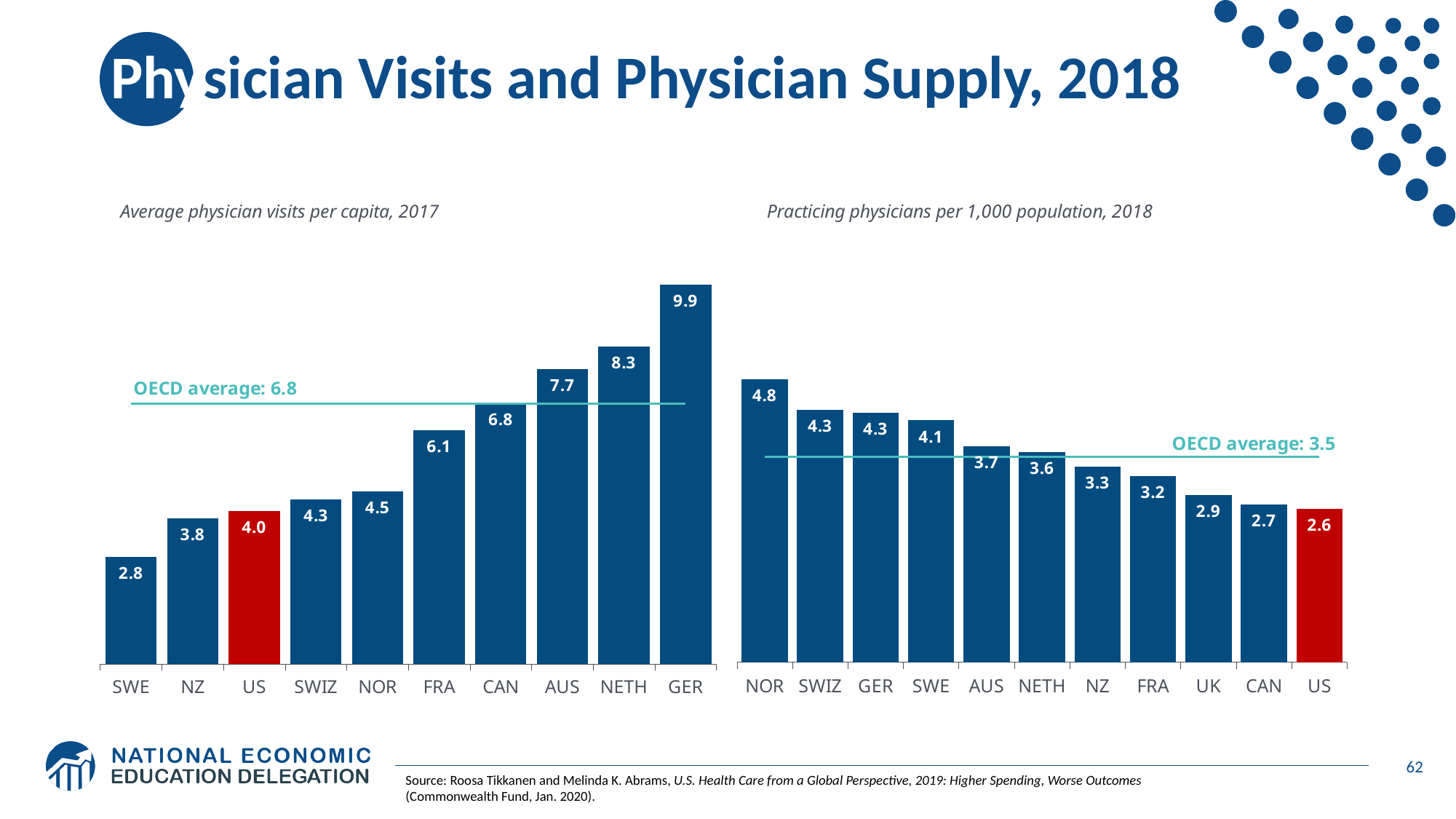
In the 'Practicing physicians per 1,000 population, 2018' chart, do the values rise or fall from left to right? fall In the 'Average physician visits per capita, 2017' chart, what is the OECD average shown? 6.8 In the 'Practicing physicians per 1,000 population, 2018' chart, how many countries are shown? 11 In the 'Practicing physicians per 1,000 population, 2018' chart, which country has the lowest value? US In the 'Average physician visits per capita, 2017' chart, what is the difference between GER and US? 5.9 In the 'Practicing physicians per 1,000 population, 2018' chart, what is the difference between NOR and US? 2.2 In the 'Practicing physicians per 1,000 population, 2018' chart, what is the value for NOR? 4.8 In the 'Average physician visits per capita, 2017' chart, which country has the lowest value? SWE In the 'Average physician visits per capita, 2017' chart, what is the value for GER? 9.9 What type of chart is the 'Average physician visits per capita, 2017' chart? bar chart In the 'Practicing physicians per 1,000 population, 2018' chart, which is larger, SWE or AUS? SWE In the 'Average physician visits per capita, 2017' chart, how many countries are shown? 10